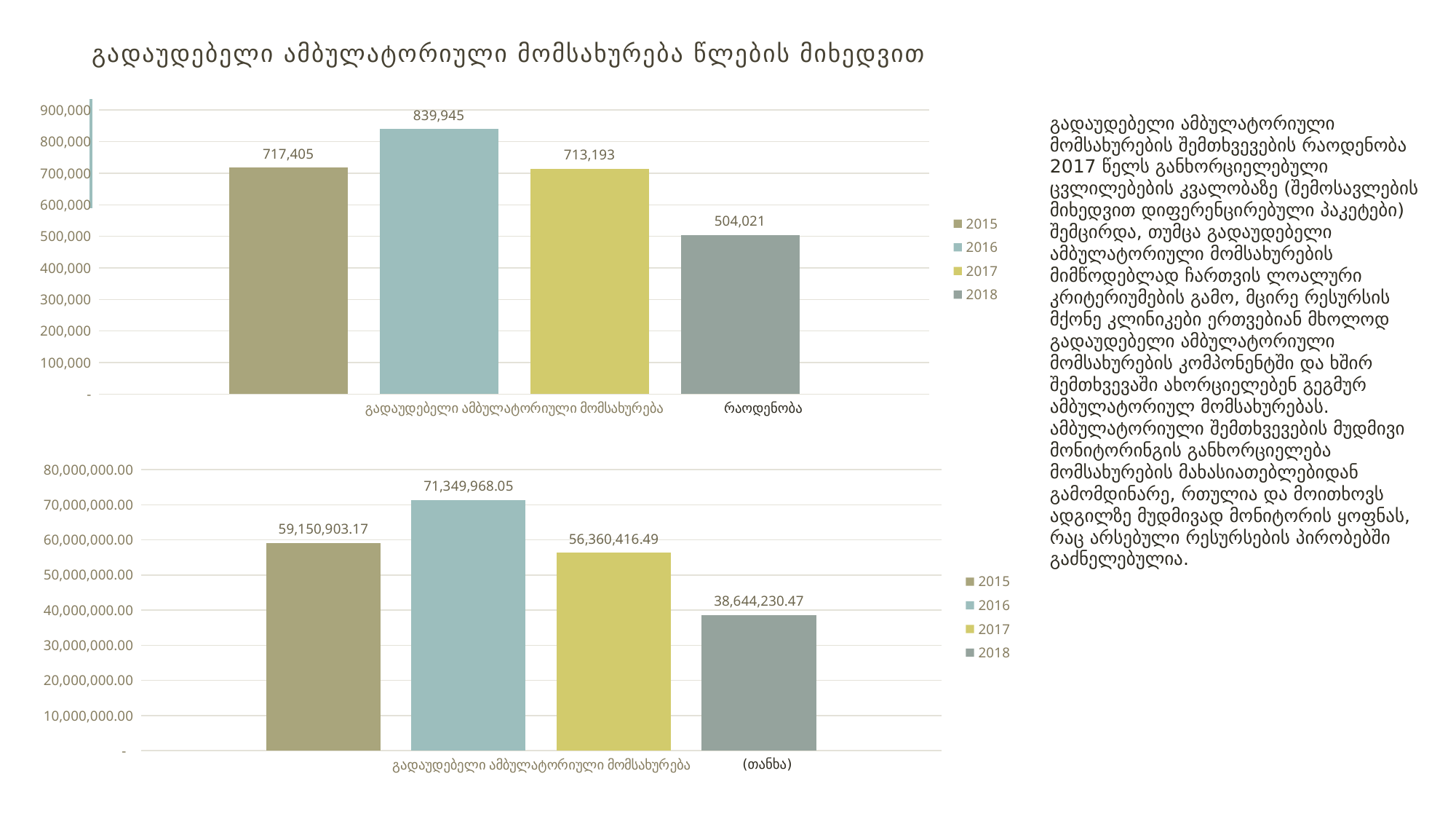
On the top chart, what is the value for 2018? 504,021 What kind of chart is the top chart? Bar chart On the top chart, which is larger, the value for 2015 or the value for 2017? 2015 On the bottom chart, which year has the lowest value? 2018 On the bottom chart, what is the value for 2016? 71,349,968.05 How many series does the legend of the bottom chart list? 4 On the top chart, what is the value for 2016? 839,945 On the top chart, which year has the highest value? 2016 On the bottom chart, what is the difference between the 2016 and 2017 values? 14,989,551.56 On the top chart, which year has the lowest value? 2018 On the bottom chart, what is the value for 2018? 38,644,230.47 On the top chart, what is the difference between the 2016 and 2015 values? 122,540